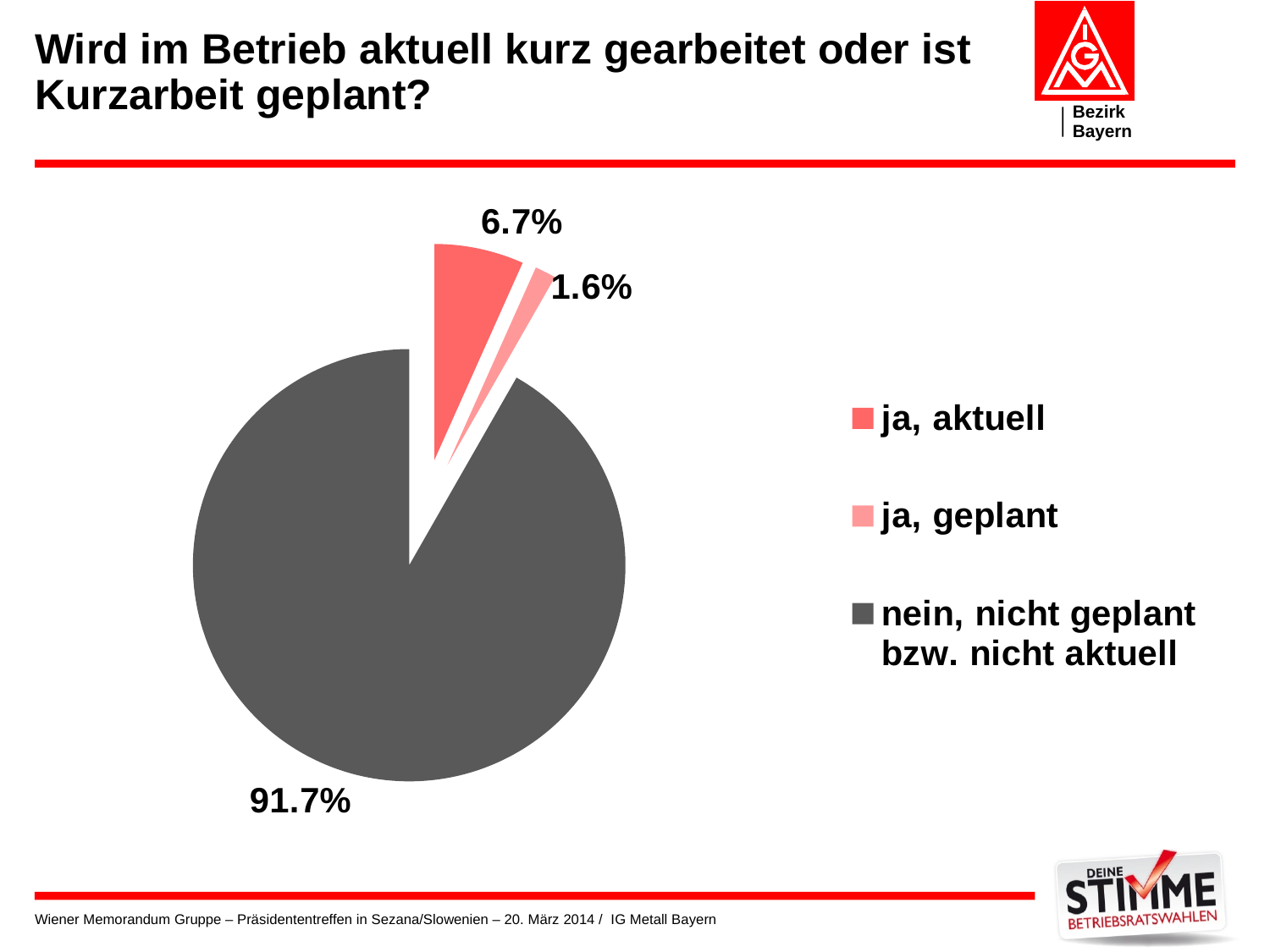
What share of the pie does "ja, geplant" have? 1.6% What share of the pie does "ja, aktuell" have? 6.7% Which category has the smallest slice of the pie? ja, geplant What is the combined share of "ja, aktuell" and "ja, geplant"? 8.3% How many entries does the legend list? 3 What kind of chart is shown on the slide? pie chart What colour is the slice for "nein, nicht geplant bzw. nicht aktuell"? dark grey How many slices does the pie chart have? 3 What share of the pie does "nein, nicht geplant bzw. nicht aktuell" have? 91.7% Which is larger, the slice for "ja, aktuell" or the slice for "ja, geplant"? ja, aktuell Which category has the largest slice of the pie? nein, nicht geplant bzw. nicht aktuell What is the difference in percentage points between "ja, aktuell" and "ja, geplant"? 5.1